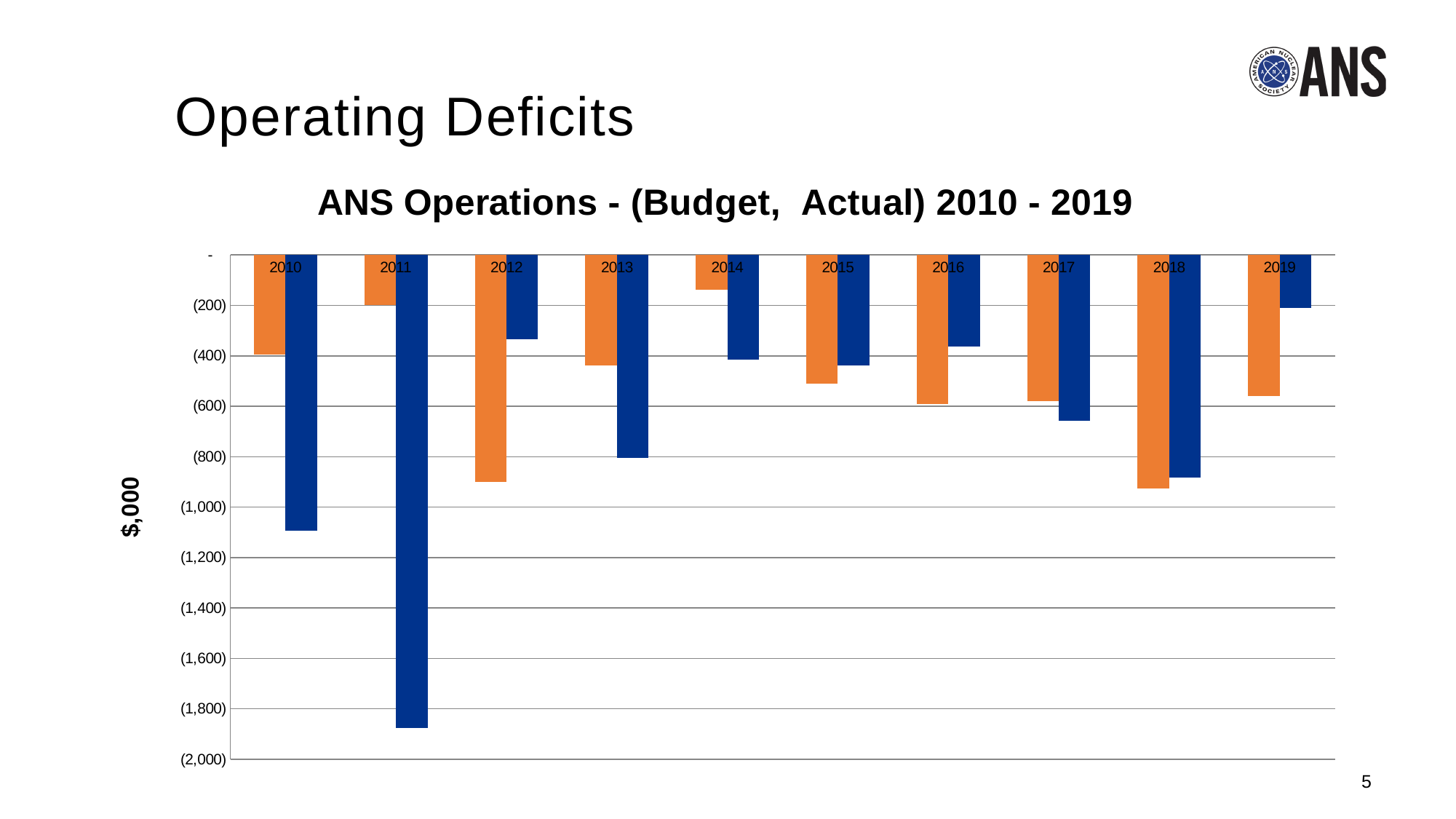
What type of chart is shown on the slide? bar chart Is the value of the blue bar for 2011 greater or less than (1,800)? less How many years are shown along the x axis of the chart? 10 What is the title of the chart? ANS Operations - (Budget, Actual) 2010 - 2019 Is the value of the blue bar for 2012 greater or less than (400)? greater Is the value of the orange bar for 2014 greater or less than (200)? greater In 2010, which bar shows the larger deficit, the orange bar or the blue bar? blue In which year is the blue bar closest to zero (smallest deficit)? 2019 What is the label on the vertical axis of the chart? $,000 In which year is the orange bar closest to zero (smallest deficit)? 2014 In which year does the blue bar reach its lowest value (largest deficit)? 2011